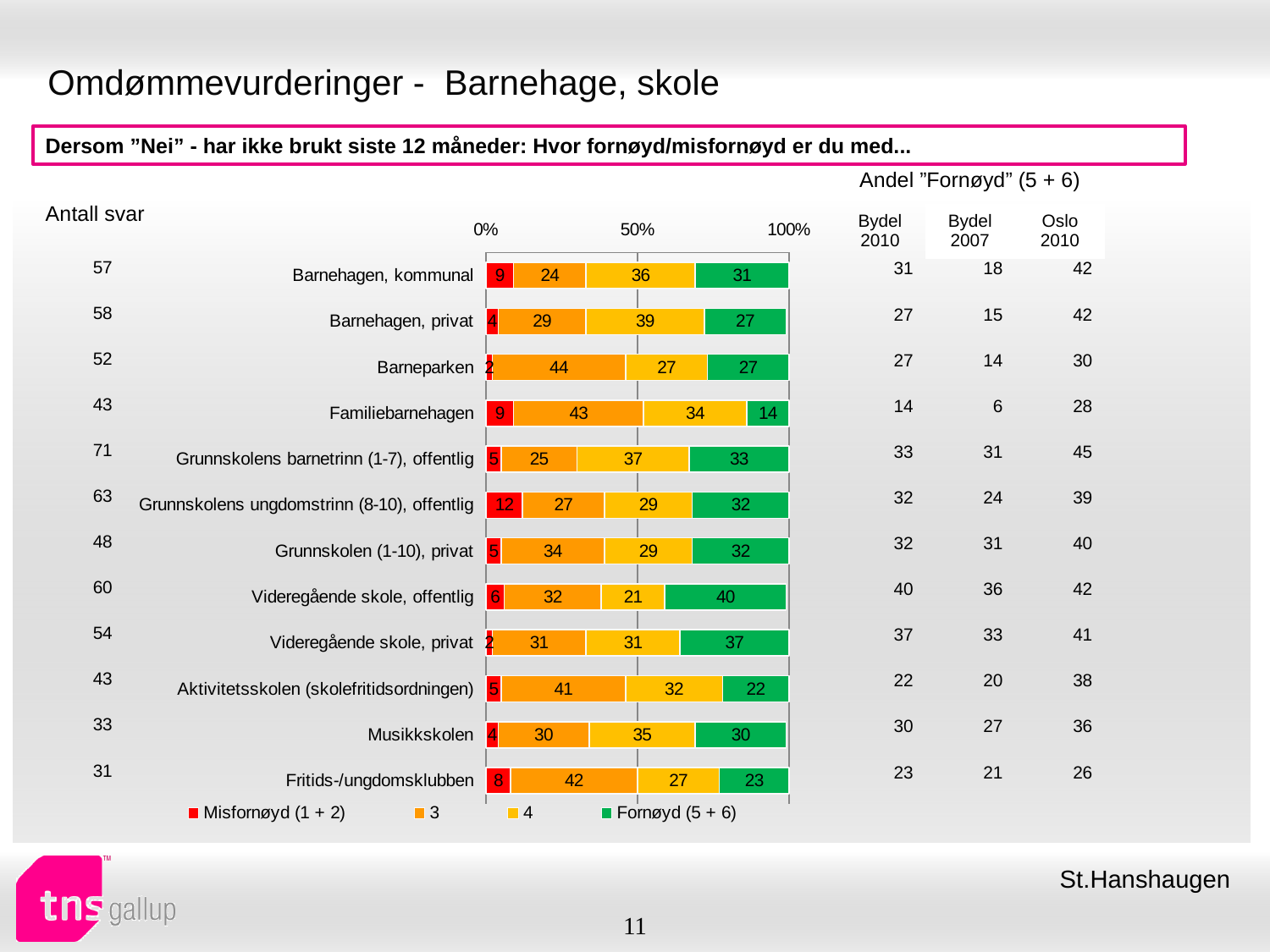
What is the Misfornøyd (1 + 2) value for Grunnskolens ungdomstrinn (8-10), offentlig? 12 What is the difference between the Fornøyd (5 + 6) values for Videregående skole, offentlig and Familiebarnehagen? 26 Which category has the lowest Fornøyd (5 + 6) value? Familiebarnehagen What kind of chart is shown on the slide? Stacked bar chart How many categories (rows) are plotted in the bar chart? 12 What is the Fornøyd (5 + 6) value for Barnehagen, kommunal? 31 Which category has the highest Misfornøyd (1 + 2) value? Grunnskolens ungdomstrinn (8-10), offentlig Which category has the highest Fornøyd (5 + 6) value? Videregående skole, offentlig What is the value of the '3' segment for Fritids-/ungdomsklubben? 42 What colour represents the Fornøyd (5 + 6) series in the legend? Green How many series does the chart legend list? 4 Which has the larger Fornøyd (5 + 6) value: Barnehagen, kommunal or Barnehagen, privat? Barnehagen, kommunal